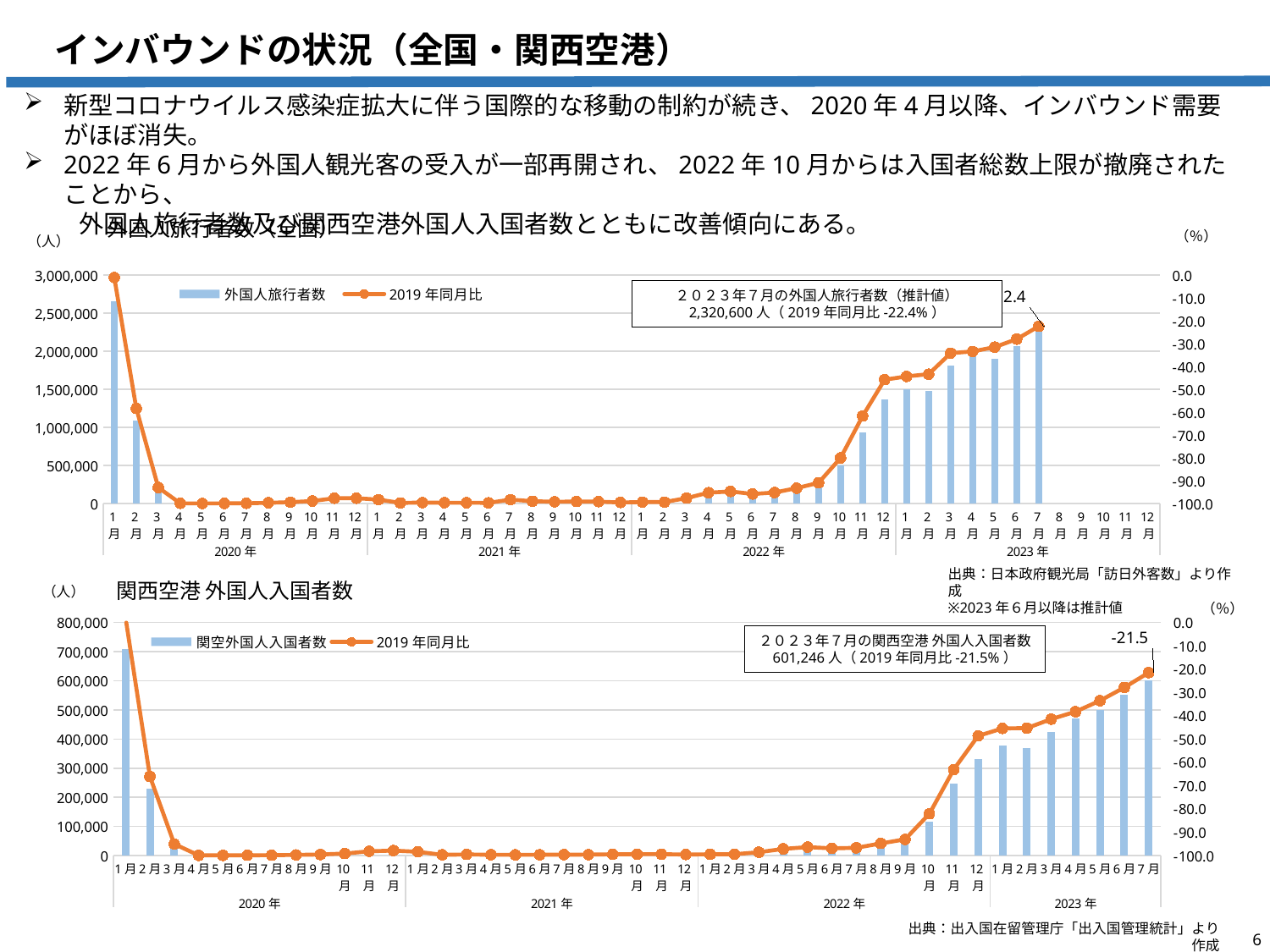
In the bottom chart (関西空港 外国人入国者数), is the bar for 2020年1月 greater or less than 600,000? greater In the bottom chart (関西空港 外国人入国者数), what is the number of foreign entrants for 2023年7月 given in the annotation? 601,246人 In the bottom chart (関西空港 外国人入国者数), what is the 2019年同月比 for 2023年7月? -21.5% In the top chart (外国人旅行者数（全国）), which bar is larger: 2020年1月 or 2023年7月? 2020年1月 What kind of chart is the top chart, 外国人旅行者数（全国）? Combined bar and line chart In the top chart (外国人旅行者数（全国）), what is the 2019年同月比 for 2023年7月 given in the annotation? -22.4% In the top chart (外国人旅行者数（全国）), how many series does the legend list? 2 In the bottom chart (関西空港 外国人入国者数), do the bars rise or fall from 2023年1月 to 2023年7月? rise In the top chart (外国人旅行者数（全国）), is the bar for 2020年1月 greater or less than 2,500,000? greater In the top chart (外国人旅行者数（全国）), what is the number of foreign travellers for 2023年7月 (推計値) given in the annotation? 2,320,600人 In the top chart (外国人旅行者数（全国）), which month has the highest bar? 2020年1月 In the bottom chart (関西空港 外国人入国者数), what are the two legend entries? 関空外国人入国者数 and 2019年同月比